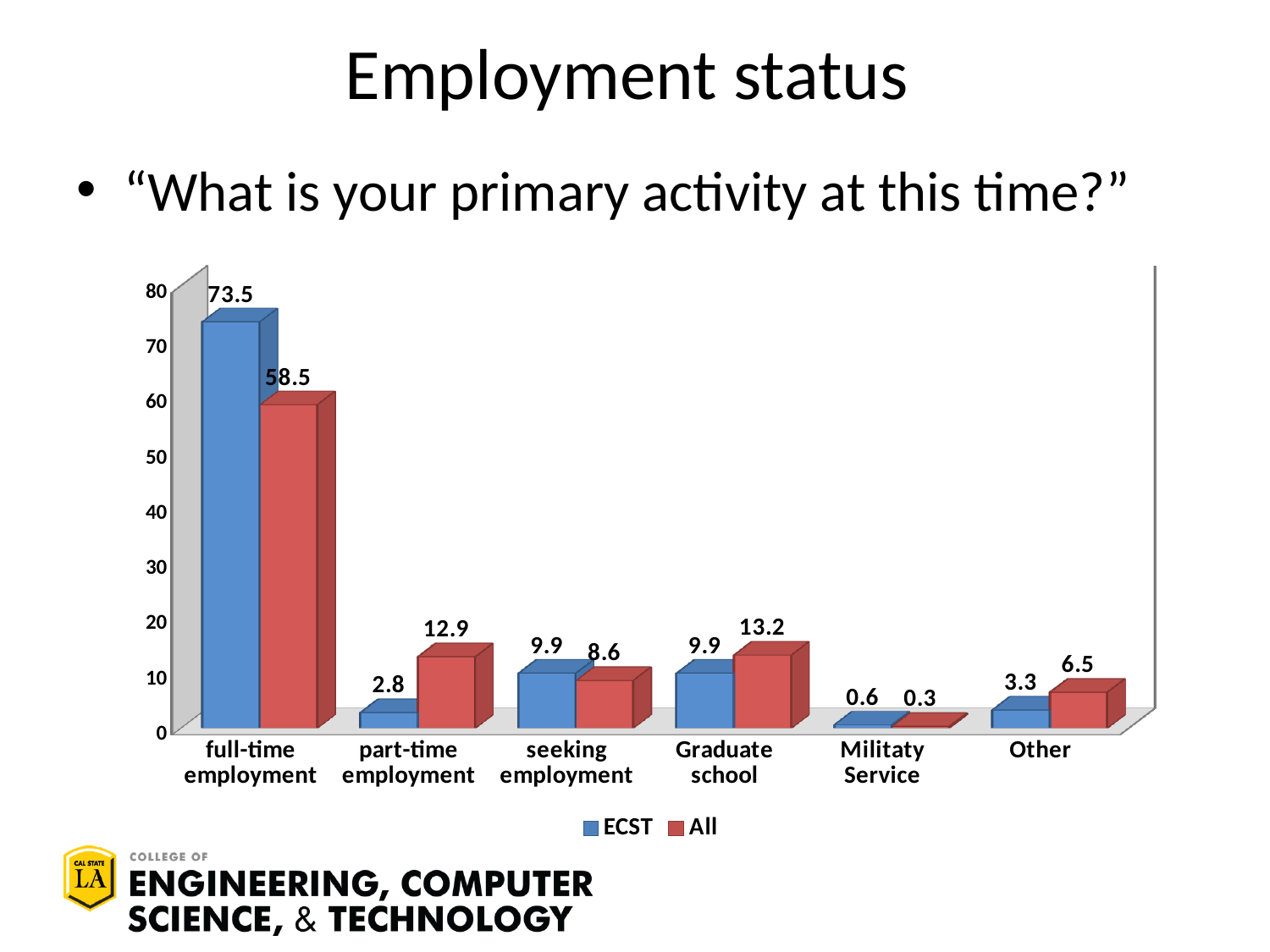
What is the All value for Graduate school? 13.2 How many series does the legend list? 2 What kind of chart is shown on the slide? bar chart What is the ECST value for Militaty Service? 0.6 Which category has the lowest All value? Militaty Service What is the ECST value for full-time employment? 73.5 What is the difference between the ECST and All values for full-time employment? 15 Which category has the highest ECST value? full-time employment Which is larger for seeking employment, the ECST value or the All value? ECST Which series is shown in red in the legend? All How many categories are shown on the x axis? 6 What is the All value for part-time employment? 12.9